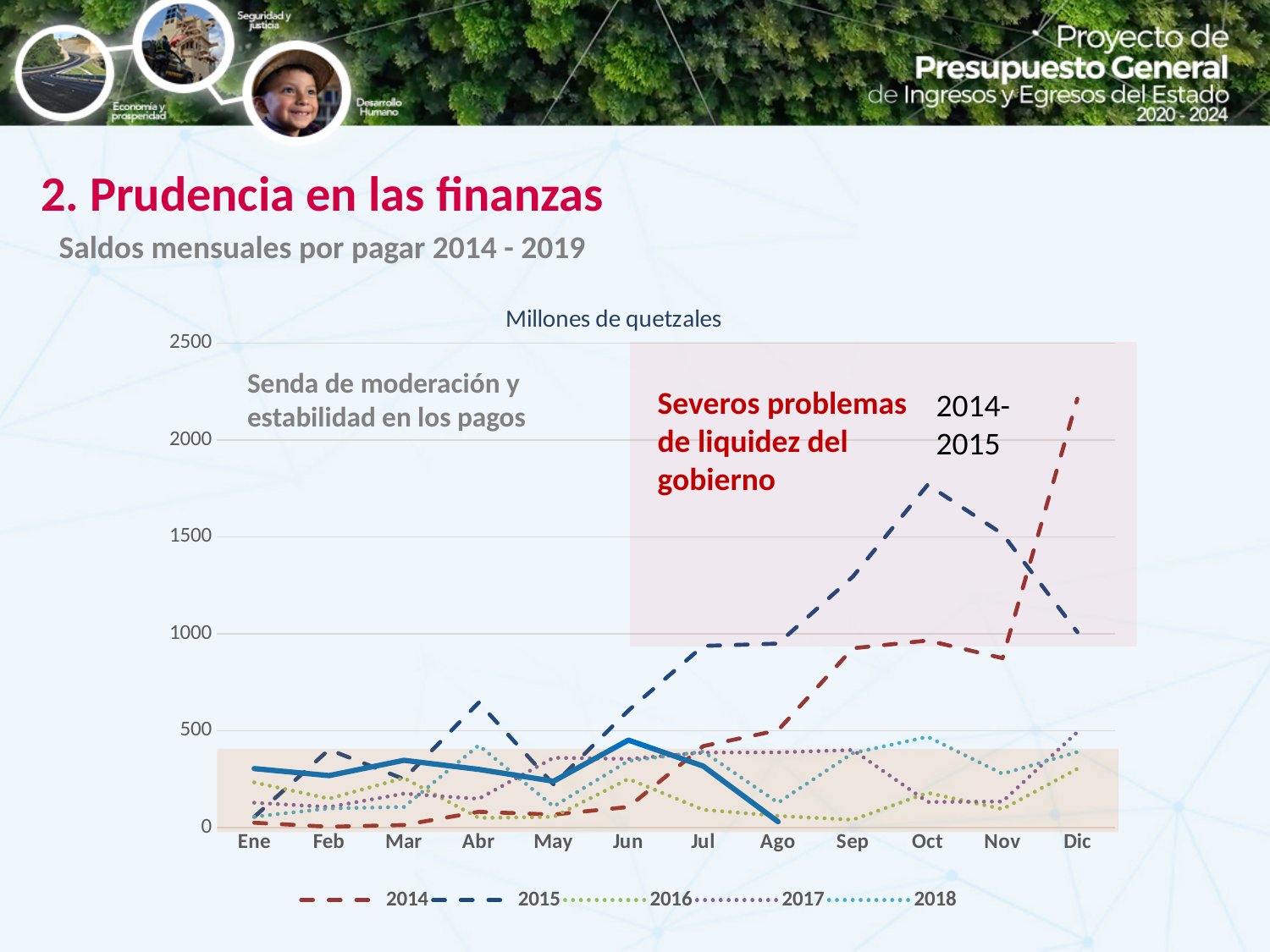
Is the value for 2014 in Dic greater or less than 2000? greater Which month has the highest value for the 2014 series? Dic Is the value for 2014 in Jul greater or less than 500? less What unit is stated above the chart? Millones de quetzales Is the value for 2015 in Oct greater or less than 1500? greater In Oct, which series has the larger value, 2014 or 2015? 2015 In Dic, which series has the larger value, 2014 or 2015? 2014 How many series does the chart legend list? 5 How many months are shown along the x axis of the chart? 12 What kind of chart is shown on the slide? line chart Which month has the highest value for the 2015 series? Oct